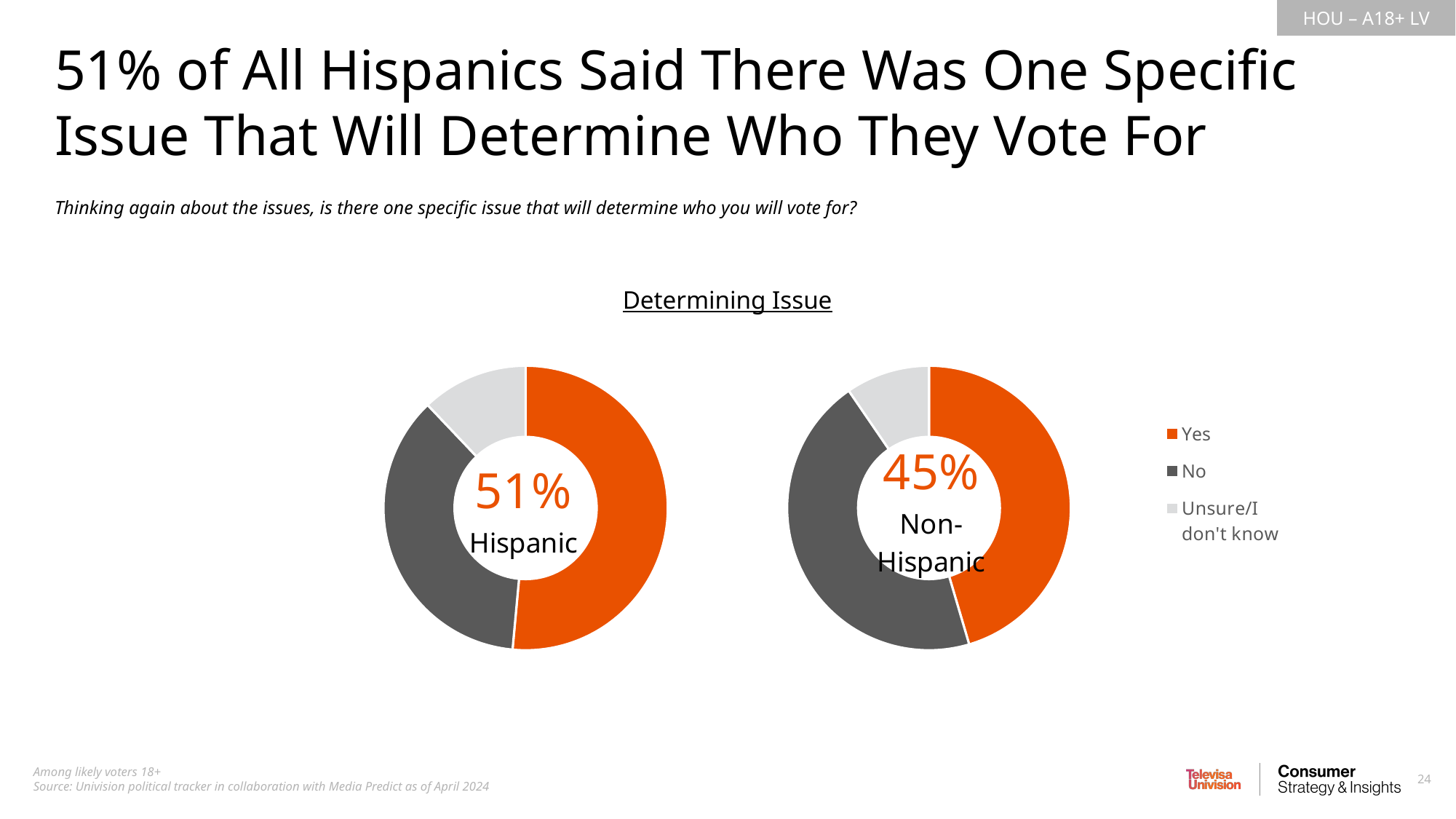
In the Non-Hispanic donut chart, what percentage said Yes? 45% In the Non-Hispanic donut chart, which response is the smallest slice? Unsure/I don't know Which colour represents the Yes response in the charts? Orange Which group has the larger Yes share, Hispanic or Non-Hispanic? Hispanic In the Hispanic donut chart, what percentage said Yes? 51% In the Hispanic donut chart, which response is the largest slice? Yes In the Hispanic donut chart, which response is the smallest slice? Unsure/I don't know How many slices does each donut chart have? 3 How many response categories does the legend list? 3 What is the title shown above the two donut charts? Determining Issue What kind of chart is used on this slide? Donut (pie) chart What is the difference between the Yes share for Hispanics and the Yes share for Non-Hispanics? 6 percentage points